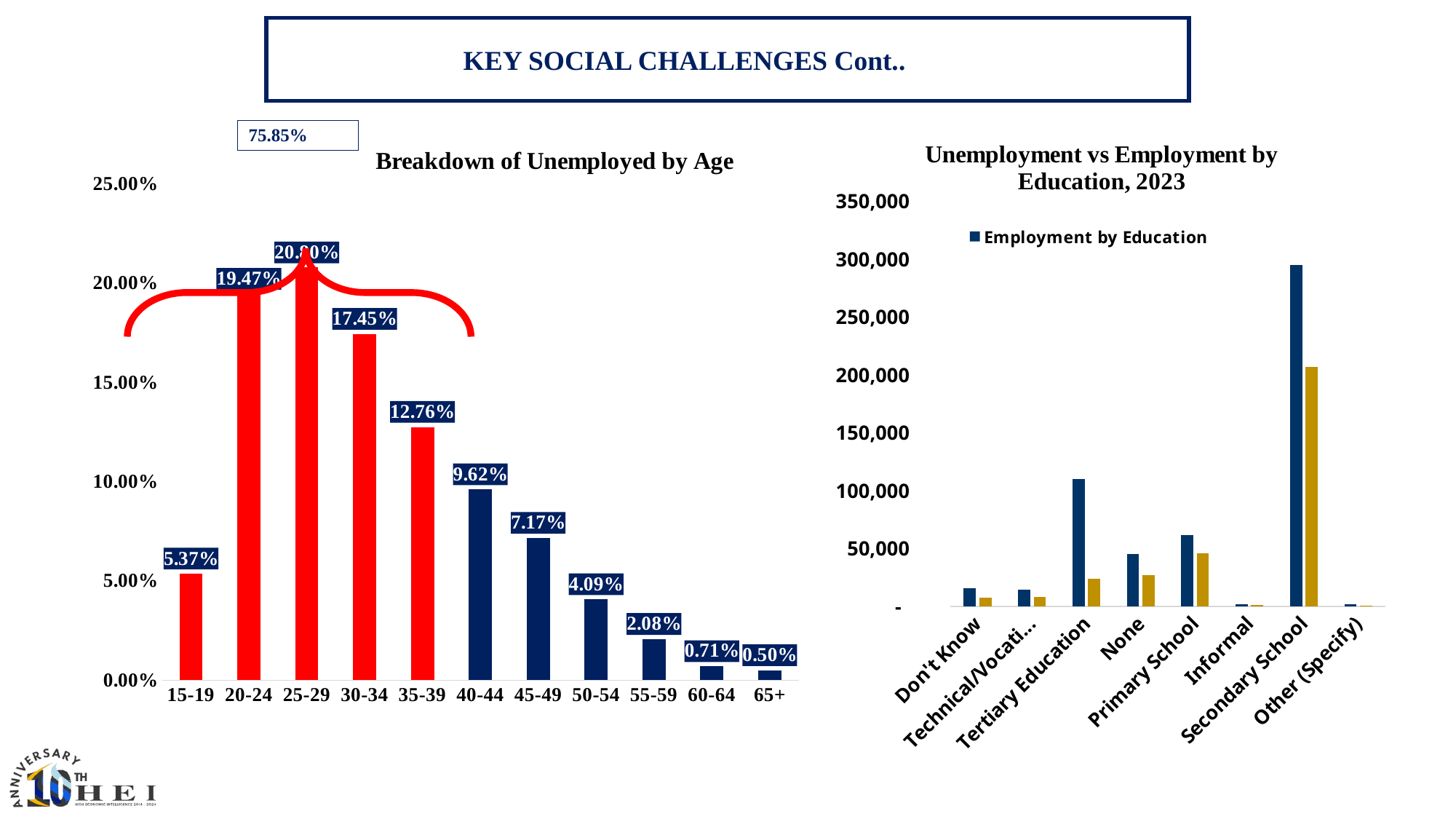
In the 'Breakdown of Unemployed by Age' chart, what is the difference between the values for 20-24 and 30-34? 2.02% In the 'Breakdown of Unemployed by Age' chart, what is the value for the 50-54 age group? 4.09% How many age groups are shown in the 'Breakdown of Unemployed by Age' chart? 11 What type of chart is 'Unemployment vs Employment by Education, 2023'? bar chart In the 'Breakdown of Unemployed by Age' chart, which is larger, the value for 40-44 or the value for 45-49? 40-44 In the 'Breakdown of Unemployed by Age' chart, which age group has the highest share of unemployed? 25-29 In the 'Unemployment vs Employment by Education, 2023' chart, is the navy bar for Secondary School greater or less than 250,000? greater In the 'Breakdown of Unemployed by Age' chart, what is the value for the 35-39 age group? 12.76% In the 'Breakdown of Unemployed by Age' chart, which age group has the lowest share of unemployed? 65+ In the 'Breakdown of Unemployed by Age' chart, do the values rise or fall from the 30-34 group to the 65+ group? fall In the 'Breakdown of Unemployed by Age' chart, what is the value for the 15-19 age group? 5.37% In the 'Unemployment vs Employment by Education, 2023' chart, which education category has the tallest bars? Secondary School